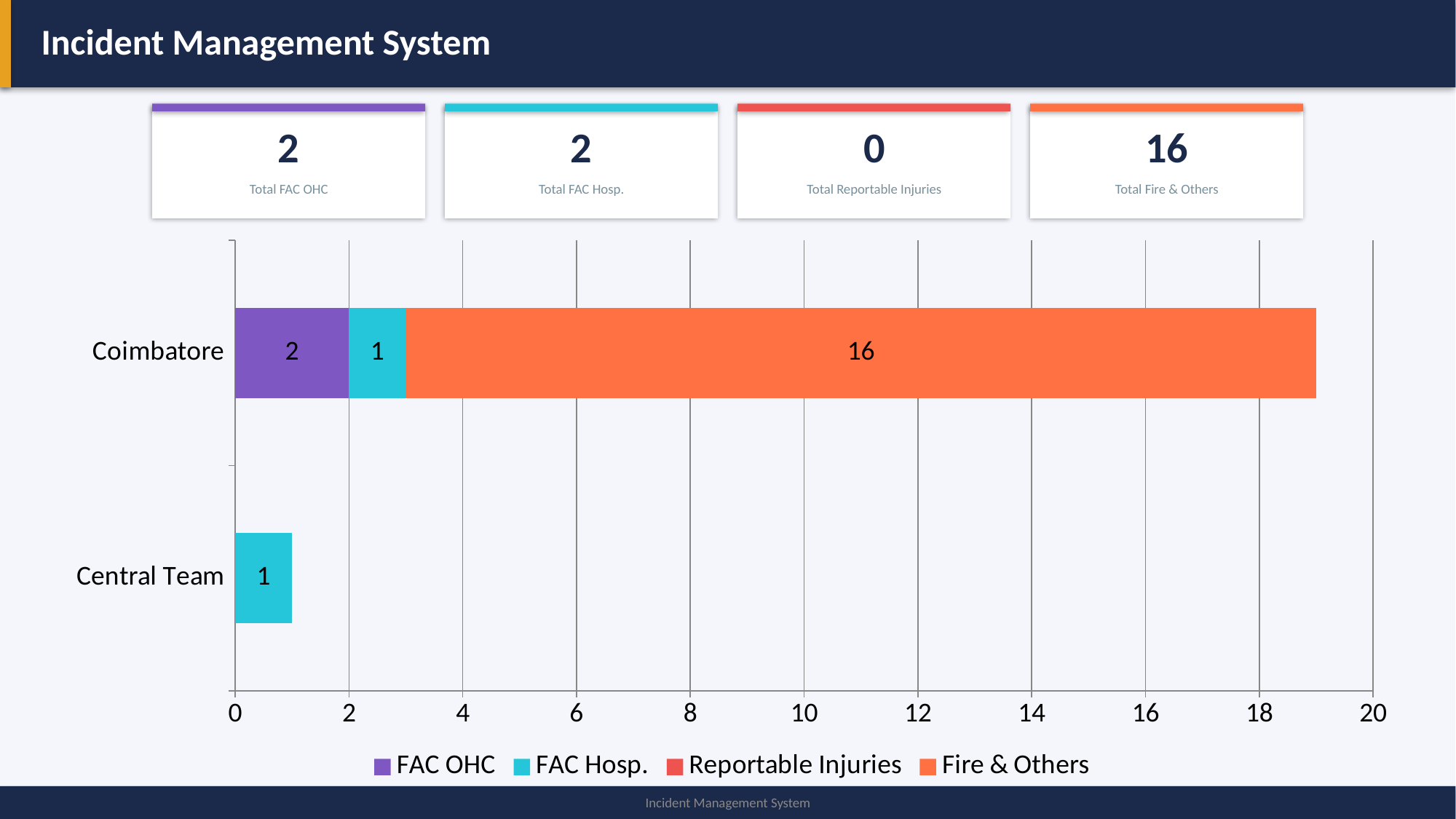
Is the Fire & Others value for Coimbatore larger than the FAC OHC value for Coimbatore? Yes What is the total of the stacked bar for Coimbatore? 19 What is the FAC Hosp. value for Coimbatore? 1 What is the FAC Hosp. value for Central Team? 1 What is the difference between the Fire & Others value and the FAC OHC value for Coimbatore? 14 How many categories are shown on the chart? 2 How many series does the legend list? 4 What kind of chart is shown on the slide? Stacked bar chart What is the Fire & Others value for Coimbatore? 16 Which category has the shortest stacked bar? Central Team What is the FAC OHC value for Coimbatore? 2 Which category has the longest stacked bar? Coimbatore